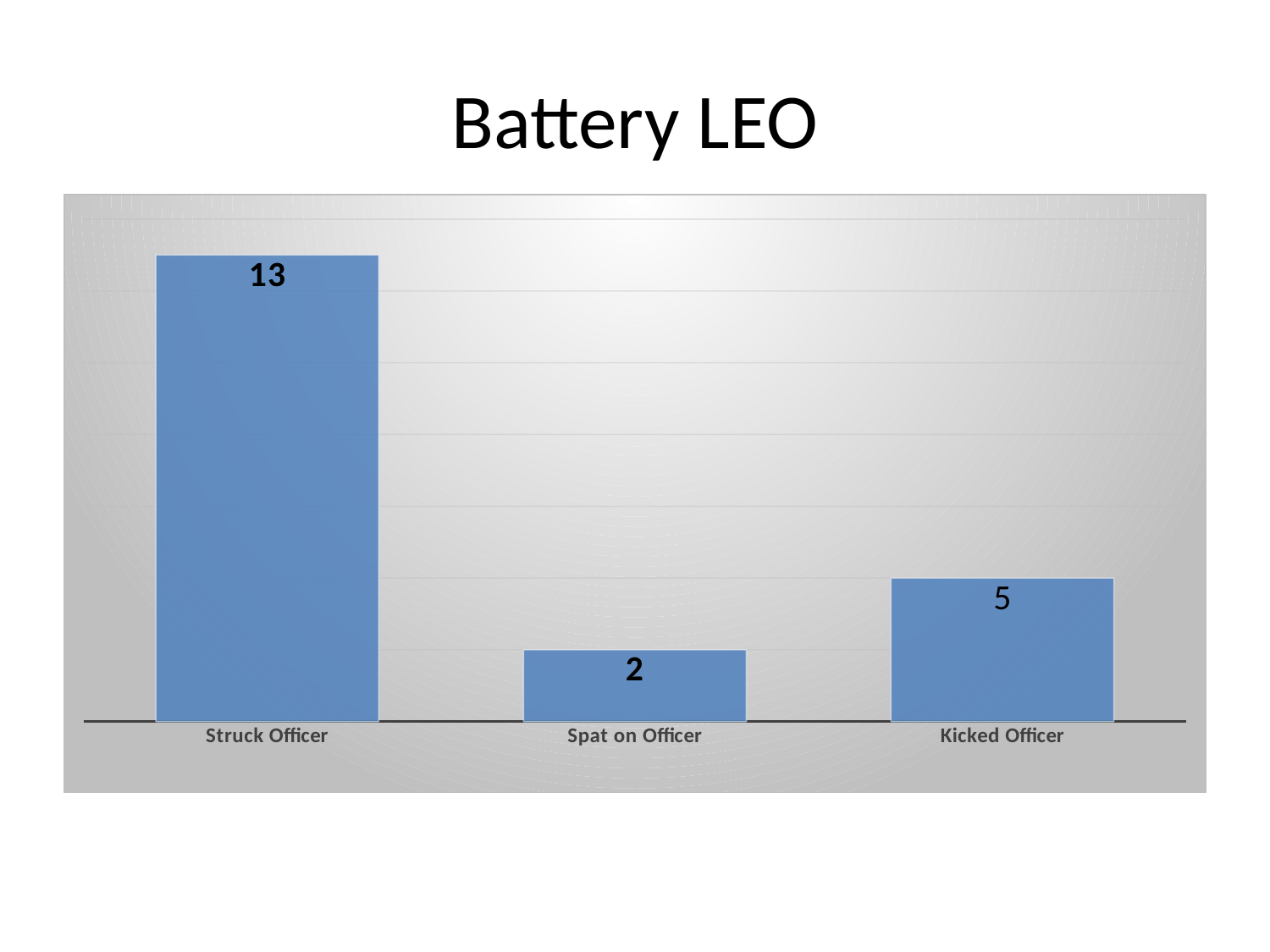
Which category has the highest value? Struck Officer What is the value for Spat on Officer? 2 Which category has the lowest value? Spat on Officer What is the value for Struck Officer? 13 What kind of chart is shown on the slide? Bar chart How many categories are shown on the chart? 3 What is the value for Kicked Officer? 5 Which is larger, the value for Kicked Officer or the value for Spat on Officer? Kicked Officer What is the difference between the values for Struck Officer and Kicked Officer? 8 What is the title of the slide? Battery LEO What is the total of all three bars on the chart? 20 What is the difference between the values for Kicked Officer and Spat on Officer? 3